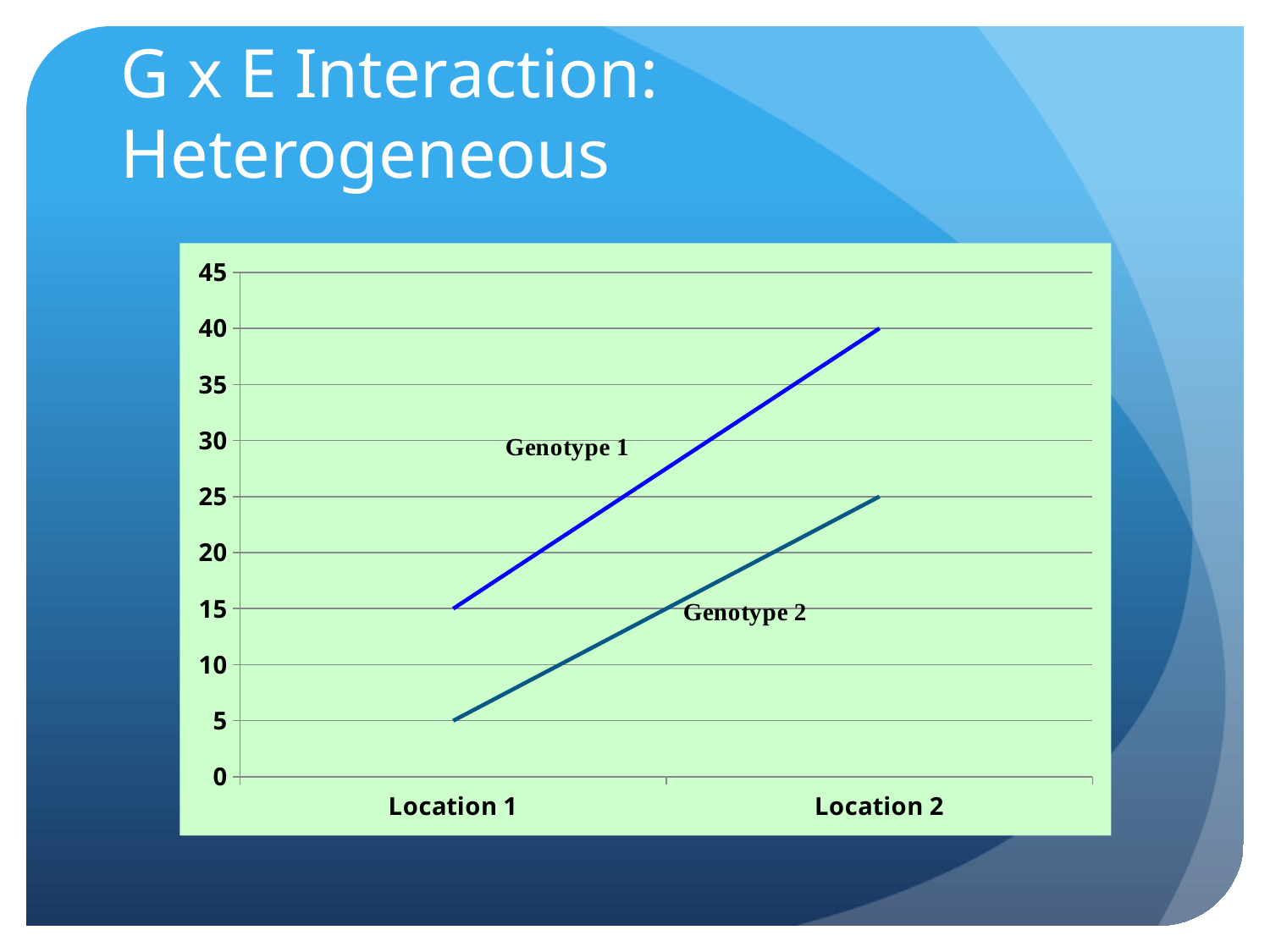
What is the difference between Genotype 1 and Genotype 2 at Location 1? 10 What is the value for Genotype 2 at Location 1? 5 What is the value for Genotype 1 at Location 2? 40 By how much does Genotype 2 increase from Location 1 to Location 2? 20 How many series are plotted on the chart? 2 What is the value for Genotype 2 at Location 2? 25 What is the value for Genotype 1 at Location 1? 15 What is the highest value shown on the y axis? 45 Does the value for Genotype 1 rise or fall from Location 1 to Location 2? rise Which genotype has the higher value at Location 2? Genotype 1 What kind of chart is shown on the slide? line chart How many locations are shown on the x axis? 2